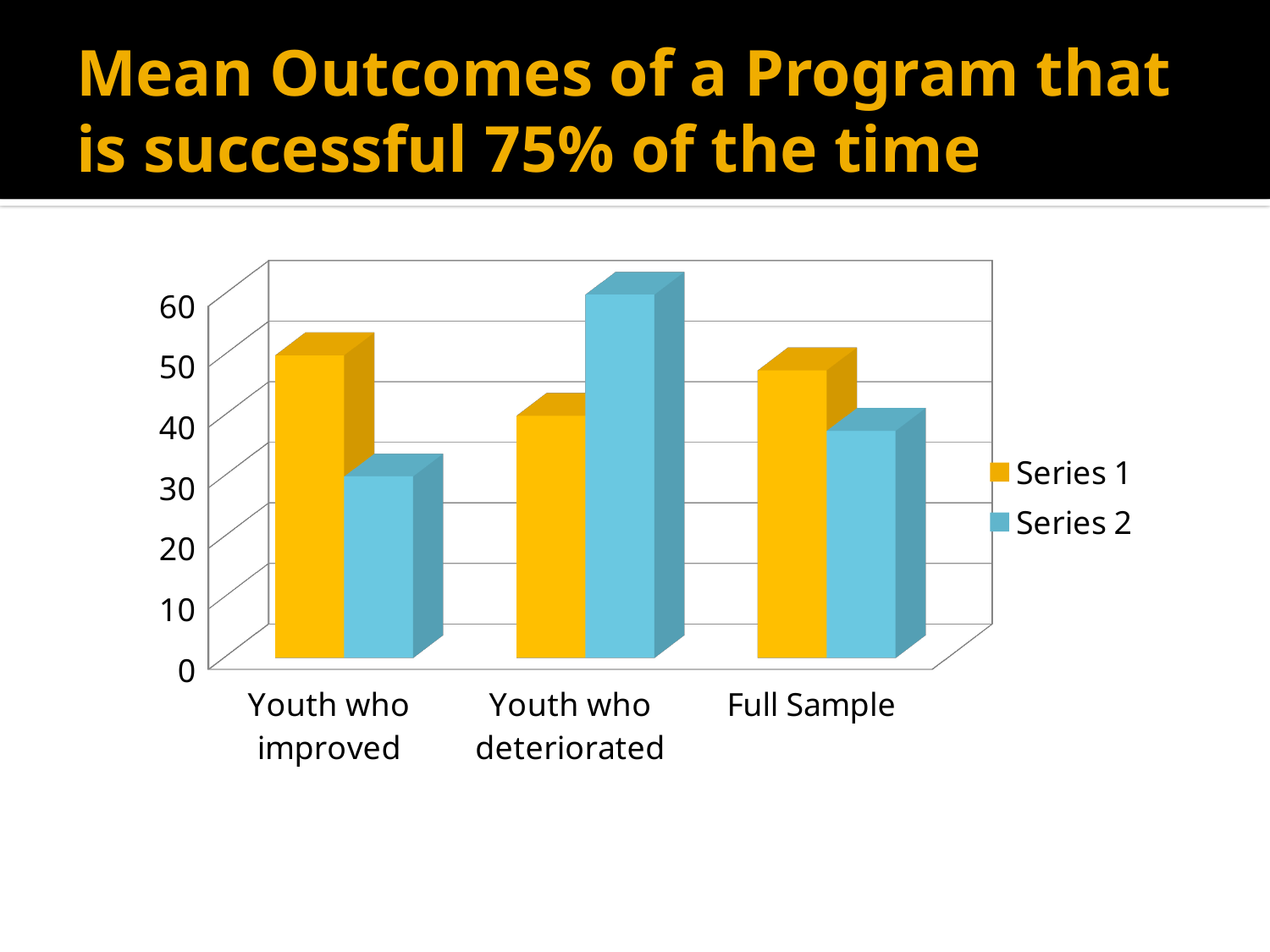
Which category has the highest Series 2 value? Youth who deteriorated For Full Sample, which is larger, Series 1 or Series 2? Series 1 How many series does the legend list? 2 What is the title of the chart on the slide? Mean Outcomes of a Program that is successful 75% of the time Is the Series 2 value for Youth who deteriorated greater or less than 50? greater For Youth who deteriorated, which is larger, Series 1 or Series 2? Series 2 How many categories are shown on the x axis? 3 What kind of chart is shown on the slide? bar chart Which category has the lowest Series 1 value? Youth who deteriorated Is the Series 2 value for Youth who improved greater or less than 40? less Which category has the lowest Series 2 value? Youth who improved For Youth who improved, which is larger, Series 1 or Series 2? Series 1